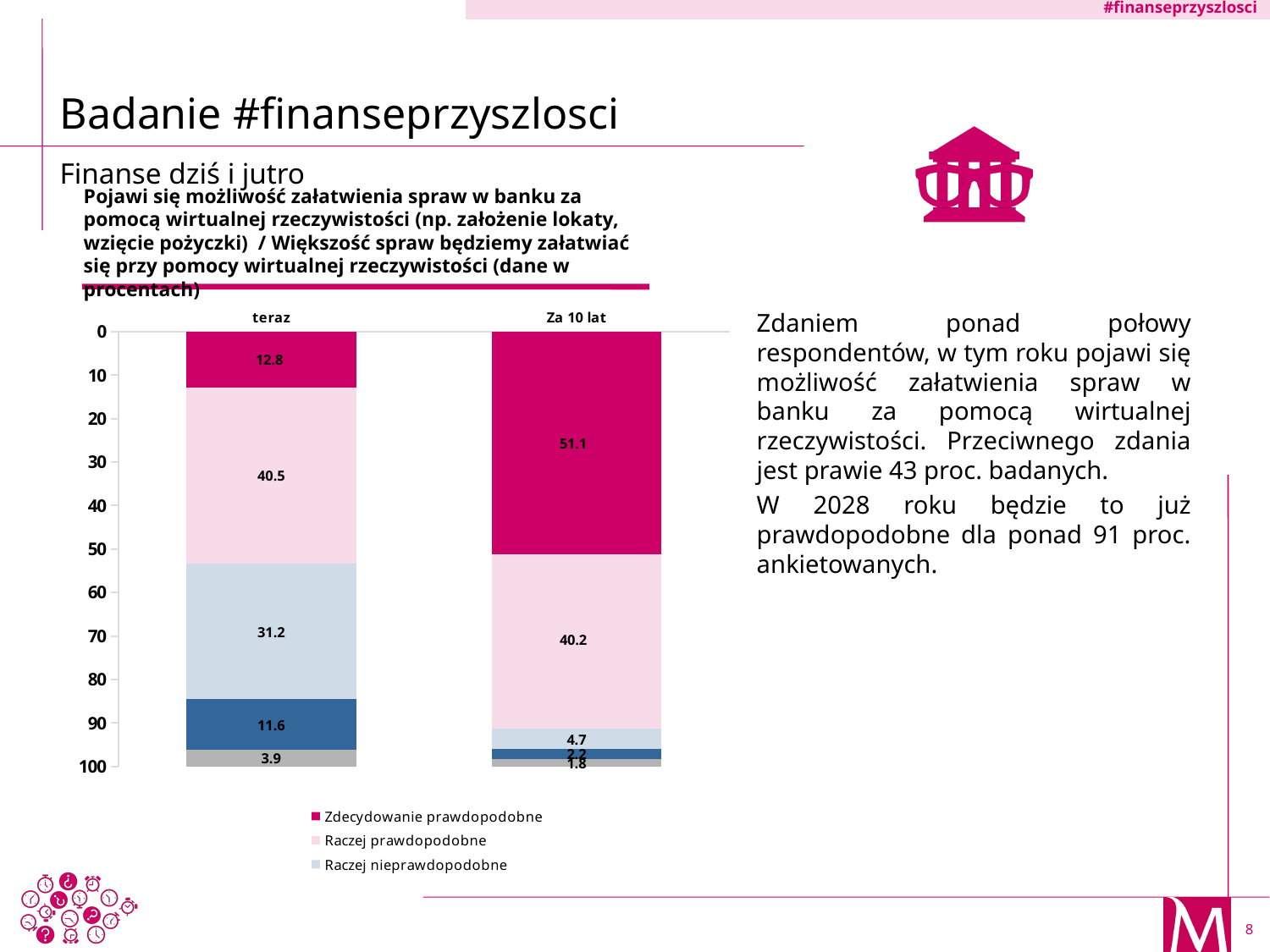
Which segment is the largest in the "Za 10 lat" bar? Zdecydowanie prawdopodobne How many series does the legend list? 3 What is the difference between the "Zdecydowanie prawdopodobne" values for "Za 10 lat" and "teraz"? 38.3 What type of chart is shown on the slide? stacked bar chart What is the value for "Zdecydowanie prawdopodobne" in the "Za 10 lat" bar? 51.1 What is the value for "Raczej nieprawdopodobne" in the "teraz" bar? 31.2 What is the value for "Zdecydowanie prawdopodobne" in the "teraz" bar? 12.8 What is the value for "Raczej nieprawdopodobne" in the "Za 10 lat" bar? 4.7 What is the value for "Raczej prawdopodobne" in the "teraz" bar? 40.5 How many categories (bars) are shown on the x axis? 2 What is the difference between the "Raczej nieprawdopodobne" values for "teraz" and "Za 10 lat"? 26.5 Which bar has the larger value for "Zdecydowanie prawdopodobne", "teraz" or "Za 10 lat"? Za 10 lat